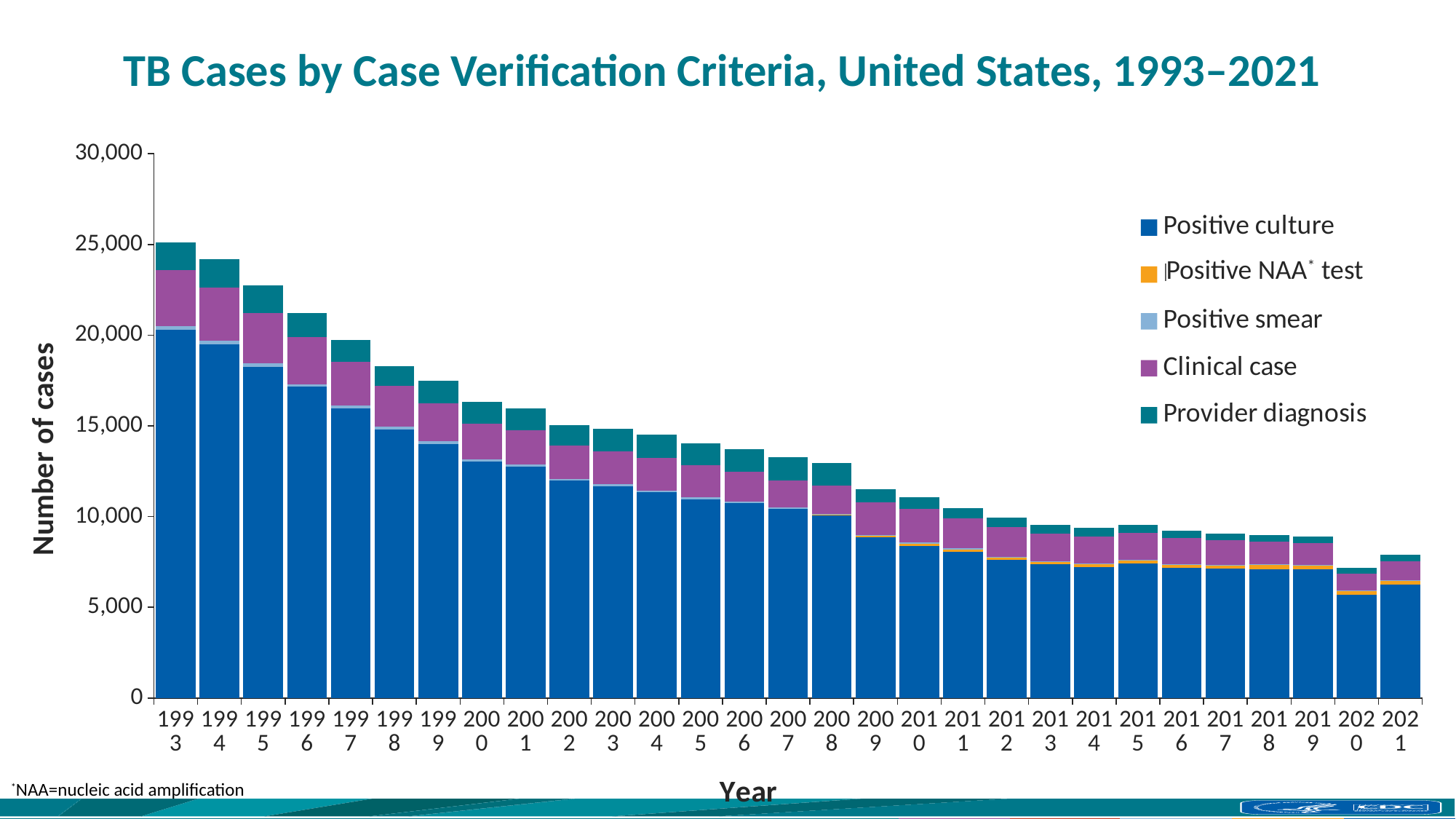
Is the total number of cases in 2020 greater or less than 10,000? less What kind of chart is shown on the slide? Stacked bar chart Which year has the larger total number of cases, 2020 or 2021? 2021 How many years (bars) are plotted on the x axis? 29 How many series does the legend list? 5 Is the total number of cases in 2010 greater or less than 10,000? greater Is the total number of cases in 1993 greater or less than 20,000? greater Which year has the highest total number of TB cases? 1993 Which year has the lowest total number of TB cases? 2020 Do the total number of cases generally rise or fall from 1993 to 2021? Fall Which case verification criterion accounts for the largest portion of each bar? Positive culture